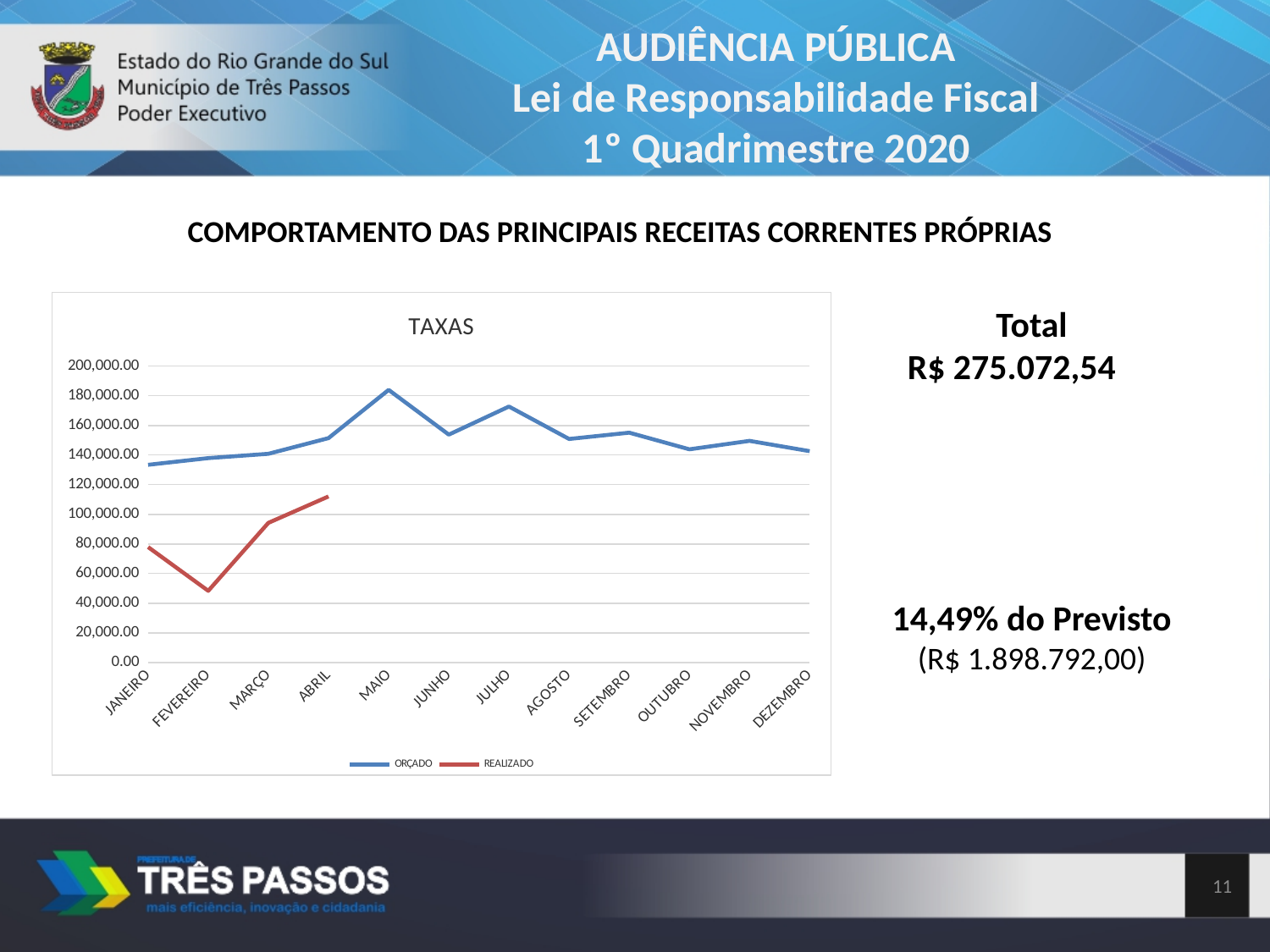
Which series is drawn in red in the chart? REALIZADO In JANEIRO, which series has the larger value, ORÇADO or REALIZADO? ORÇADO What is the title of the chart? TAXAS How many series does the chart legend list? 2 In which month does the ORÇADO series reach its highest value? MAIO Is the REALIZADO value for FEVEREIRO greater or less than 60,000.00? less Is the REALIZADO value for ABRIL greater or less than 100,000.00? greater How many months are shown on the x axis of the chart? 12 Is the ORÇADO value for MAIO greater or less than 160,000.00? greater What kind of chart is shown on the slide? line chart Does the REALIZADO series rise or fall from FEVEREIRO to ABRIL? rise In which month does the REALIZADO series reach its lowest value? FEVEREIRO